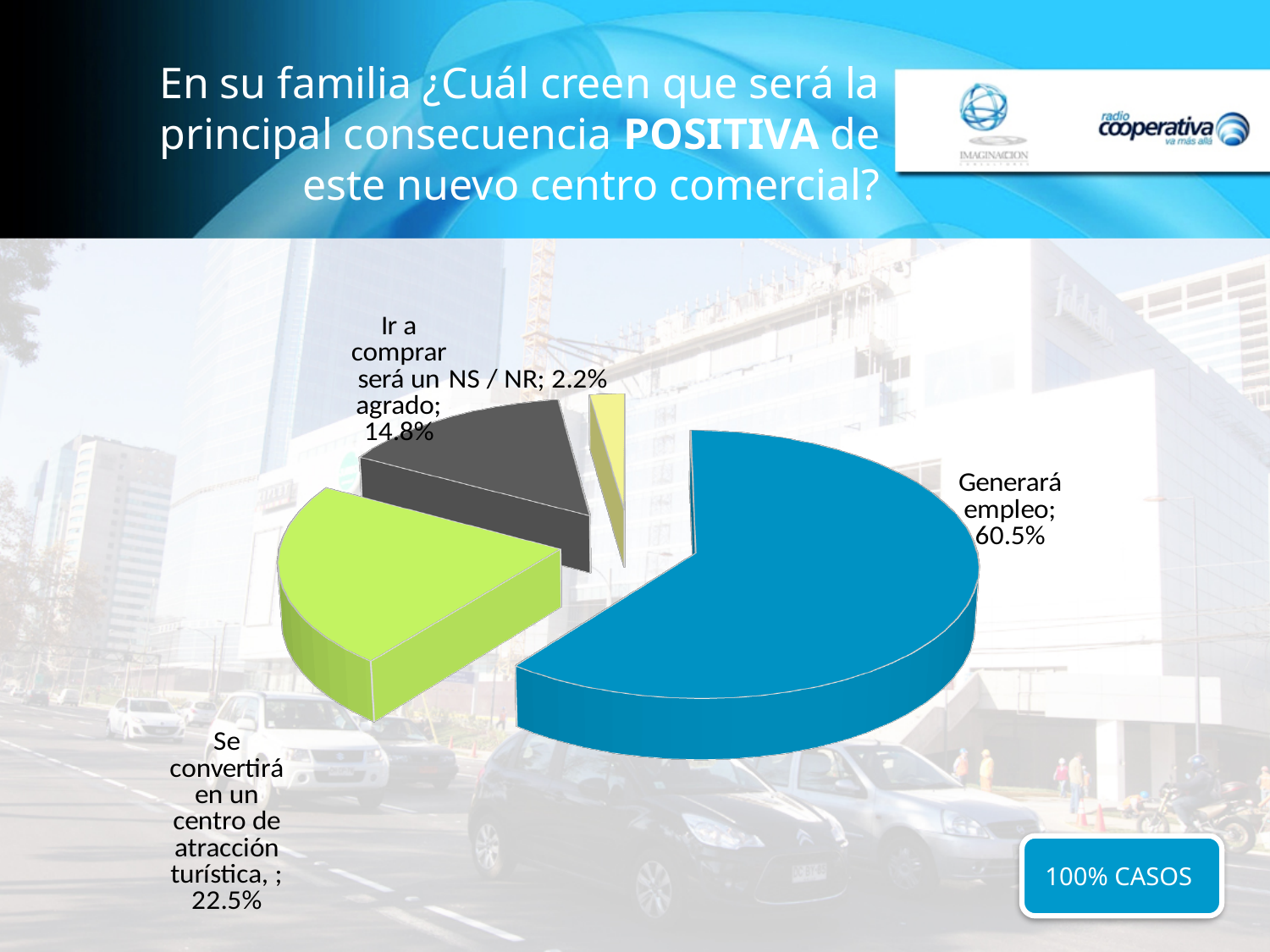
Which is larger: "Ir a comprar será un agrado" or "Se convertirá en un centro de atracción turística"? Se convertirá en un centro de atracción turística What kind of chart is shown on the slide? Pie chart What percentage of respondents said the main positive consequence would be "Generará empleo"? 60.5% Which category has the smallest slice of the pie? NS / NR Which category has the largest slice of the pie? Generará empleo What is the difference in percentage points between "Generará empleo" and "Se convertirá en un centro de atracción turística"? 38 percentage points What is the difference in percentage points between "Ir a comprar será un agrado" and "NS / NR"? 12.6 percentage points What percentage is labelled "NS / NR"? 2.2% What colour is the "Generará empleo" slice? Blue How many slices does the pie chart have? 4 What value is shown for "Ir a comprar será un agrado"? 14.8% What share of the pie corresponds to "Se convertirá en un centro de atracción turística"? 22.5%